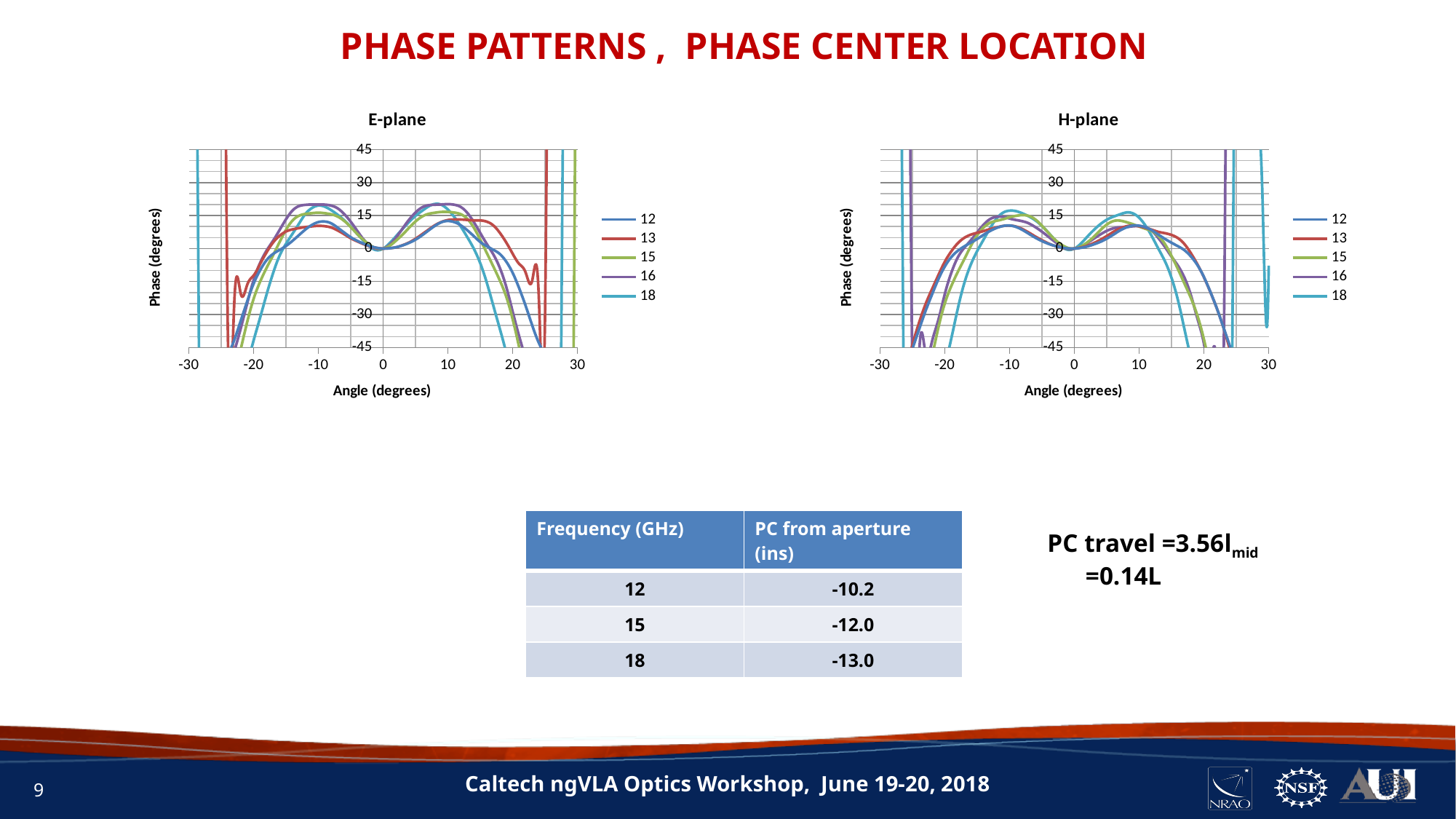
In the H-plane chart, is the value of series 13 near -10 degrees greater or less than 15? less In the E-plane chart, is the value of series 18 at 20 degrees greater or less than -30? less In the E-plane chart, what is the phase value of the series at an angle of 0 degrees? 0 In the E-plane chart, is the peak value of series 16 near -10 degrees greater or less than 15? greater In the H-plane chart, what is the phase value of the series at an angle of 0 degrees? 0 What kind of chart is the E-plane chart? line chart How many series does the legend of the H-plane chart list? 5 What is the x-axis title of the H-plane chart? Angle (degrees) What are the legend entries of the E-plane chart? 12, 13, 15, 16, 18